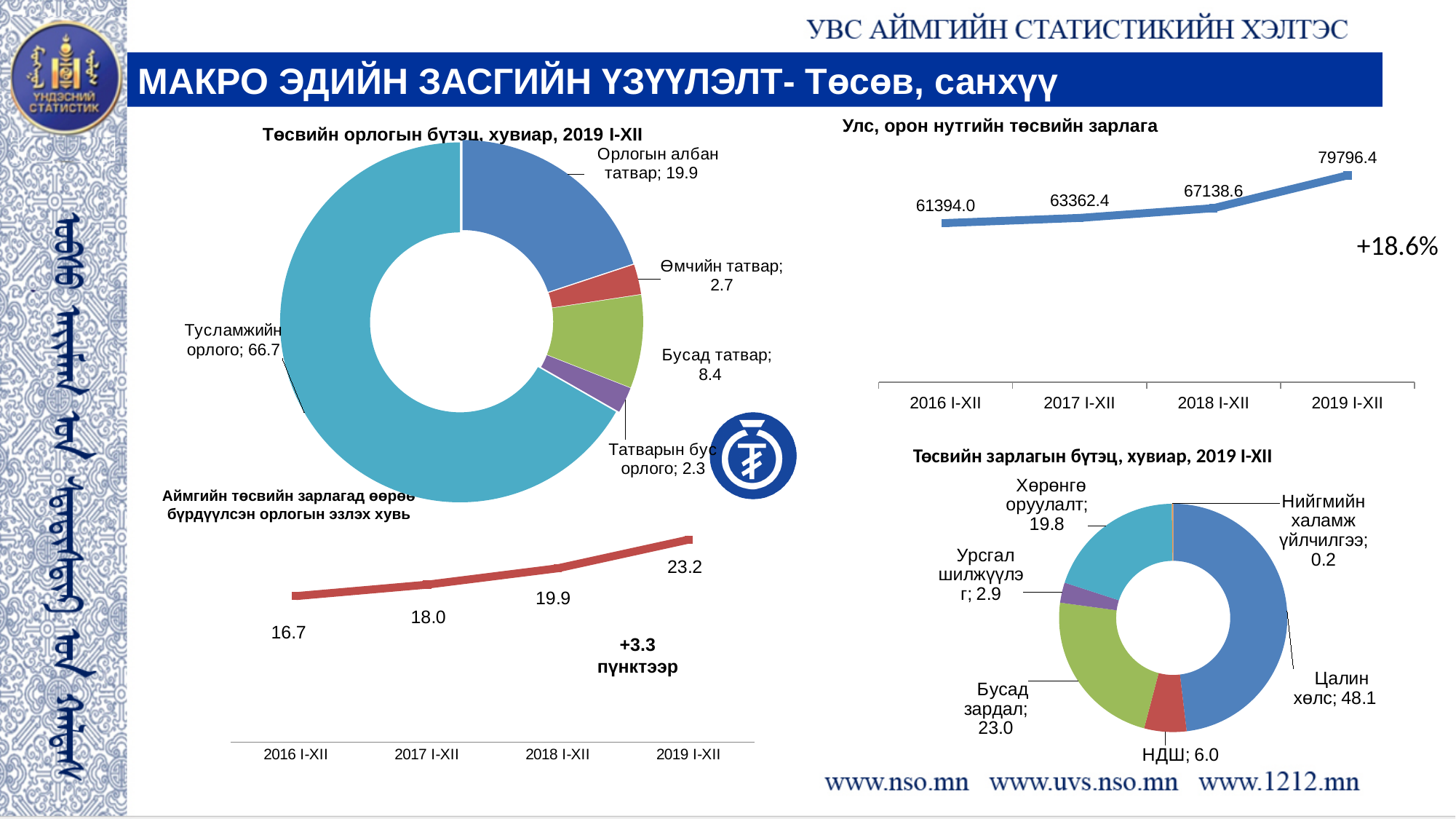
In the chart titled 'Аймгийн төсвийн зарлагад өөрөө бүрдүүлсэн орлогын эзлэх хувь', what is the difference between the 2019 I-XII and 2016 I-XII values? 6.5 In the chart titled 'Төсвийн зарлагын бүтэц, хувиар, 2019 I-XII', which is larger: 'Бусад зардал' or 'НДШ'? Бусад зардал In the chart titled 'Төсвийн орлогын бүтэц, хувиар, 2019 I-XII', which category has the smallest value? Татварын бус орлого In the chart titled 'Төсвийн орлогын бүтэц, хувиар, 2019 I-XII', what is the difference between 'Орлогын албан татвар' and 'Бусад татвар'? 11.5 In the chart titled 'Улс, орон нутгийн төсвийн зарлага', what is the value for 2019 I-XII? 79796.4 What kind of chart is the chart titled 'Төсвийн орлогын бүтэц, хувиар, 2019 I-XII'? Doughnut (pie) chart In the chart titled 'Улс, орон нутгийн төсвийн зарлага', how many data points are plotted? 4 In the chart titled 'Улс, орон нутгийн төсвийн зарлага', do the values rise or fall from 2016 I-XII to 2019 I-XII? Rise In the chart titled 'Төсвийн зарлагын бүтэц, хувиар, 2019 I-XII', which category has the largest value? Цалин хөлс In the chart titled 'Аймгийн төсвийн зарлагад өөрөө бүрдүүлсэн орлогын эзлэх хувь', what is the value for 2017 I-XII? 18.0 In the chart titled 'Төсвийн орлогын бүтэц, хувиар, 2019 I-XII', what is the value for 'Тусламжийн орлого'? 66.7 In the chart titled 'Төсвийн зарлагын бүтэц, хувиар, 2019 I-XII', what is the value for 'Хөрөнгө оруулалт'? 19.8